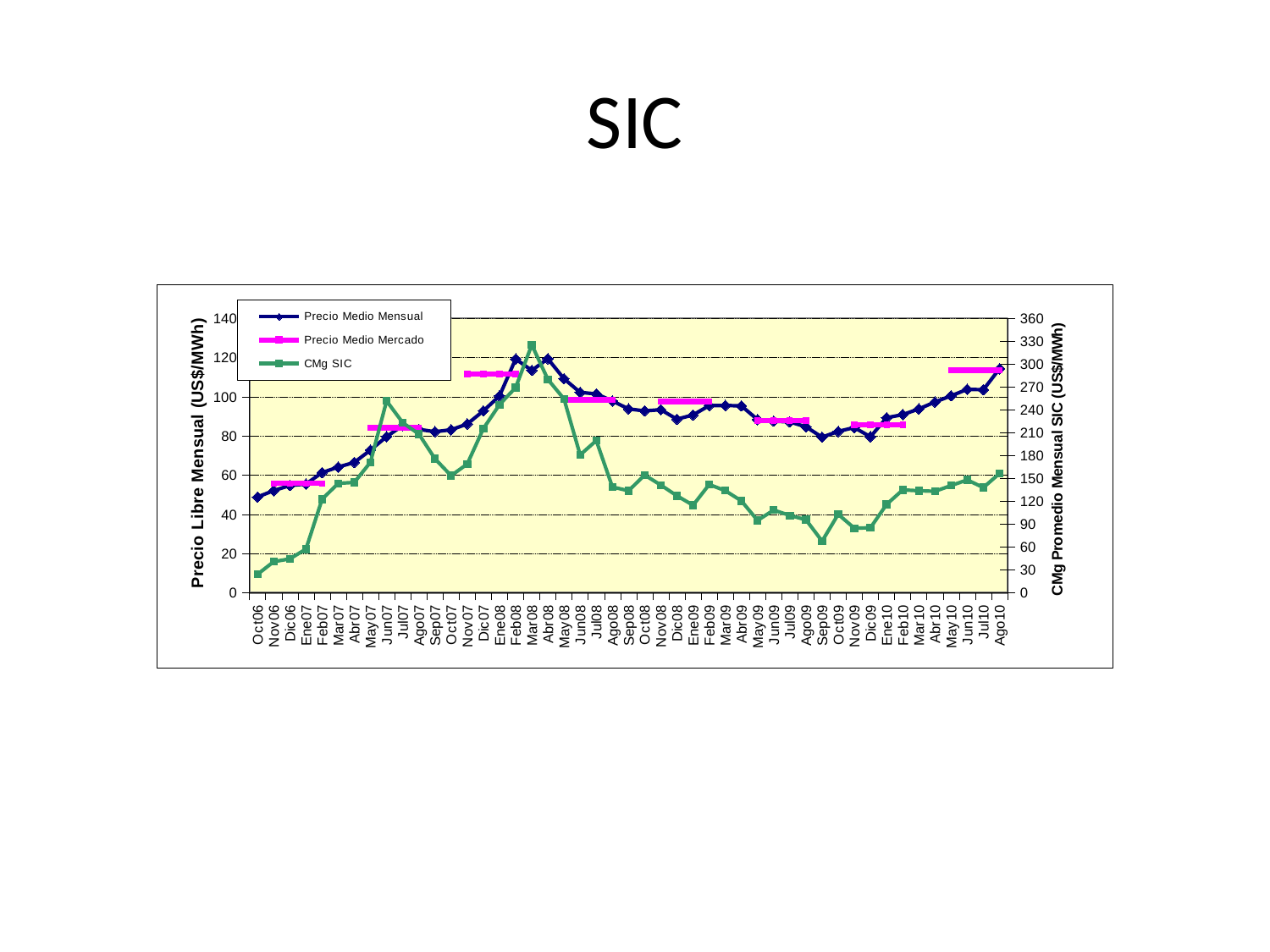
What kind of chart is shown on the slide? line chart Which month has the highest value for CMg SIC? Mar08 Is the value for CMg SIC in Sep09 greater or less than 90 on the right axis? less How many series does the legend list? 3 Which month has the lowest value for Precio Medio Mensual? Oct06 What is the title of the chart? SIC What is the label of the left vertical axis? Precio Libre Mensual (US$/MWh) Which is larger for Precio Medio Mensual: the value in Feb08 or the value in Sep09? Feb08 Is the value for CMg SIC in Mar08 greater or less than 300 on the right axis? greater Is the value for Precio Medio Mensual in Oct06 greater or less than 60? less Does Precio Medio Mensual rise or fall from Oct06 to Feb08? rise